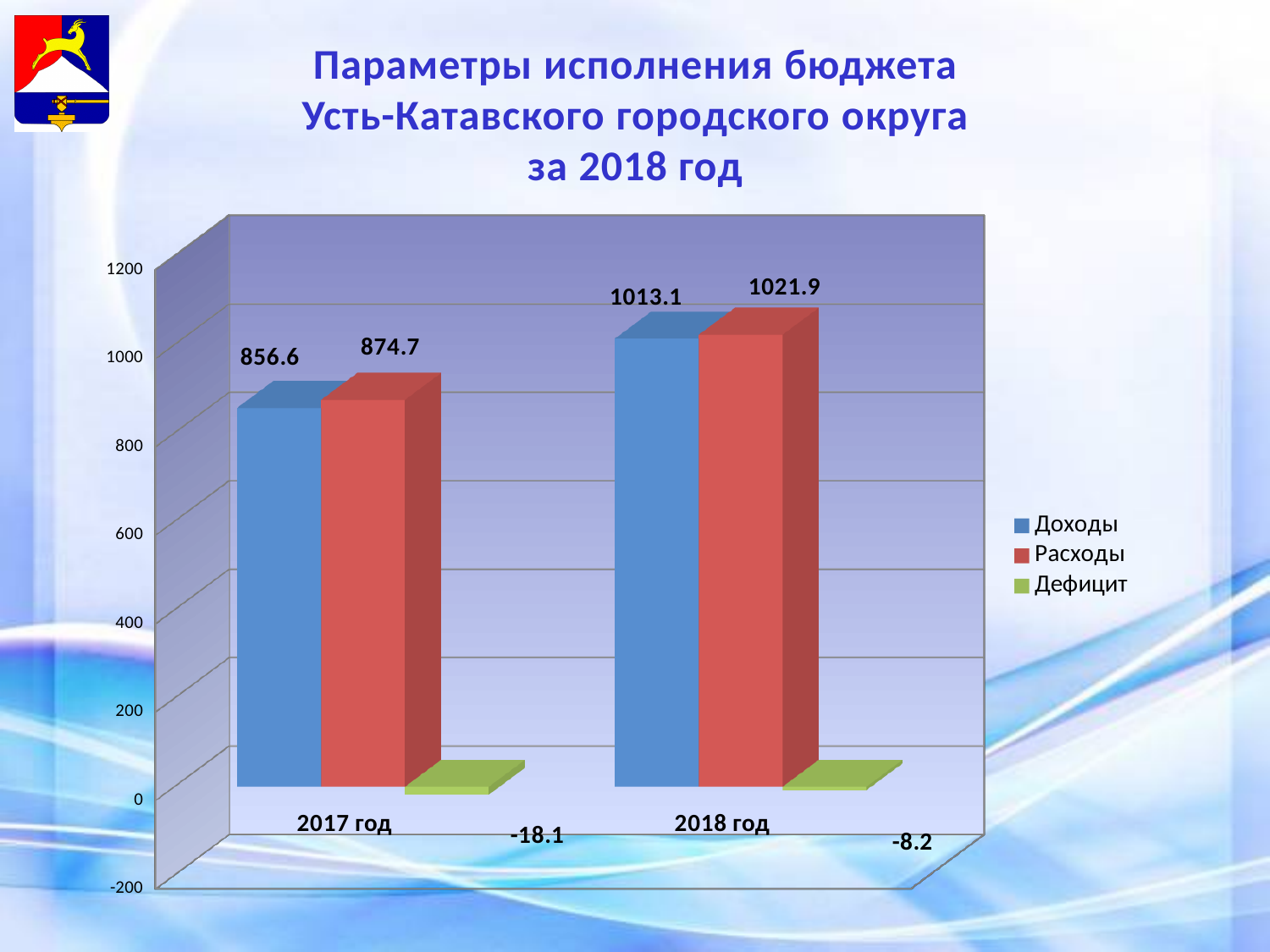
What is the value of Дефицит for 2017 год? -18.1 Which year has the higher value of Доходы? 2018 год What is the difference between Расходы and Доходы in 2018 год? 8.8 What kind of chart is shown on the slide? Bar chart Which is larger in 2017 год, Доходы or Расходы? Расходы What is the value of Доходы for 2017 год? 856.6 What is the difference between Доходы in 2018 год and Доходы in 2017 год? 156.5 What is the value of Расходы for 2018 год? 1021.9 How many year categories are shown on the x axis? 2 Do the values of Расходы rise or fall from 2017 год to 2018 год? Rise How many series does the legend list? 3 What is the value of Дефицит for 2018 год? -8.2